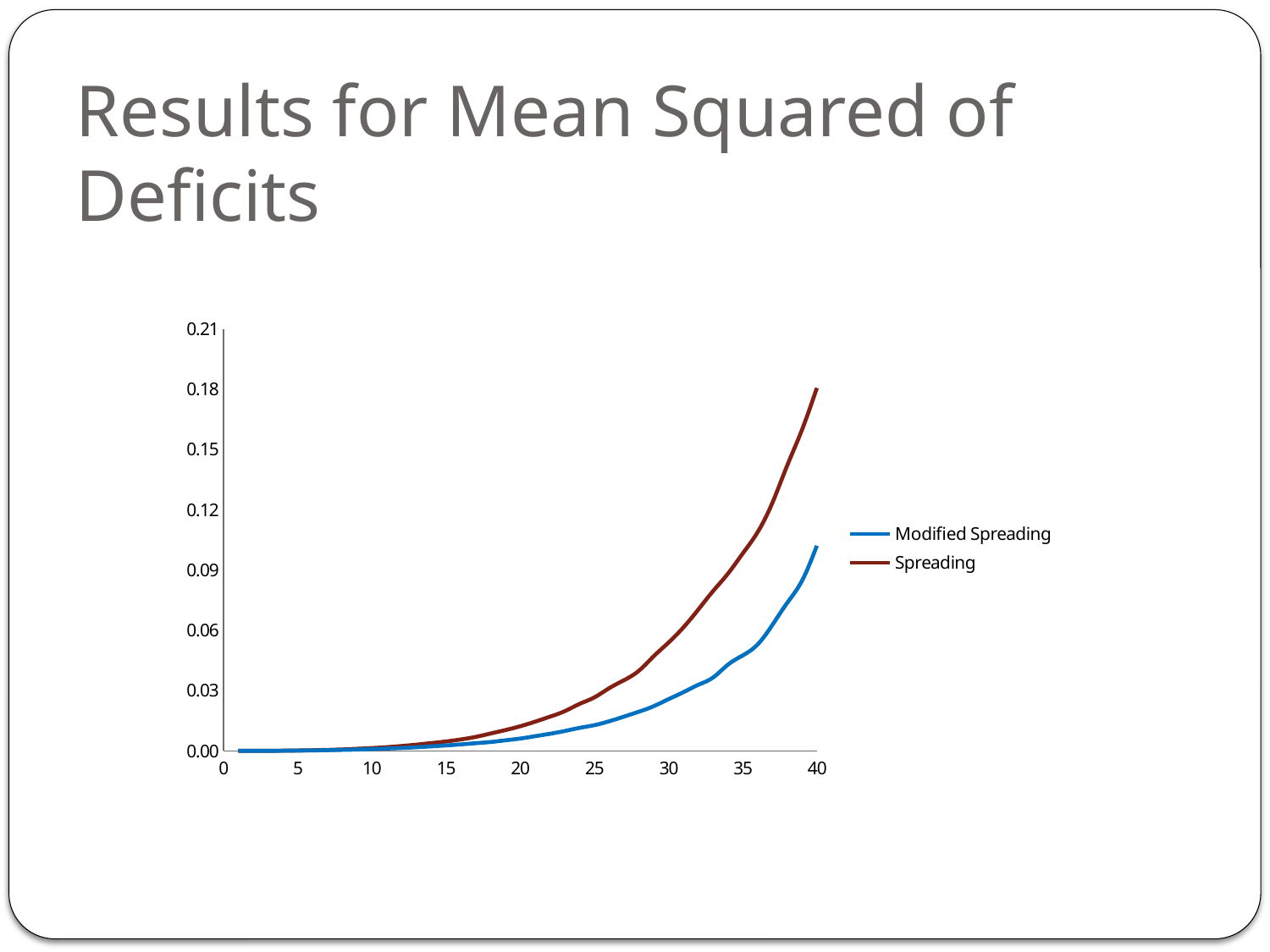
Do the values for the Spreading series rise or fall as x increases from 0 to 40? rise Which series is plotted in blue? Modified Spreading Is the value for Modified Spreading at x = 35 greater or less than 0.06? less Do the values for the Modified Spreading series rise or fall along the x axis? rise Is the value for Spreading at x = 40 greater or less than 0.15? greater Is the value for Modified Spreading at x = 40 greater or less than 0.12? less What kind of chart is shown on the slide? line chart What is the title of the slide containing the chart? Results for Mean Squared of Deficits At x = 40, which series has the larger value, Spreading or Modified Spreading? Spreading How many series does the legend list? 2